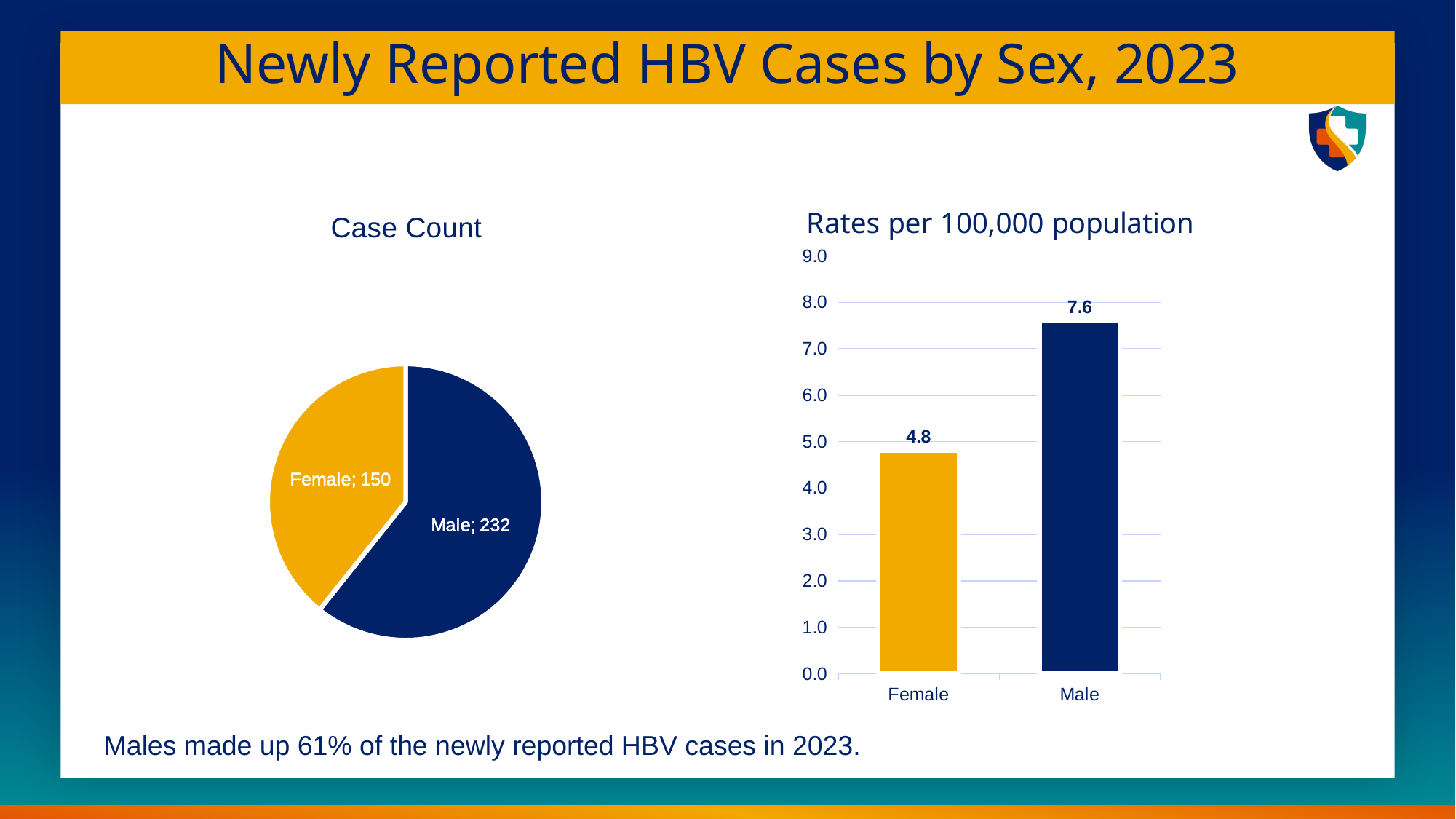
In the Rates per 100,000 population chart, which category has the highest rate? Male In the Case Count pie chart, how many cases are reported for Male? 232 In the Case Count pie chart, what is the total number of cases across both slices? 382 In the Rates per 100,000 population chart, what is the rate for Male? 7.6 In the Rates per 100,000 population chart, what is the rate for Female? 4.8 In the Rates per 100,000 population chart, what is the difference between the Male and Female rates? 2.8 In the Case Count pie chart, how many slices are there? 2 In the Case Count pie chart, how many more cases are there for Male than for Female? 82 What kind of chart is the Case Count chart? Pie chart In the Case Count pie chart, which slice is larger, Male or Female? Male What kind of chart is the Rates per 100,000 population chart? Bar chart In the Case Count pie chart, how many cases are reported for Female? 150